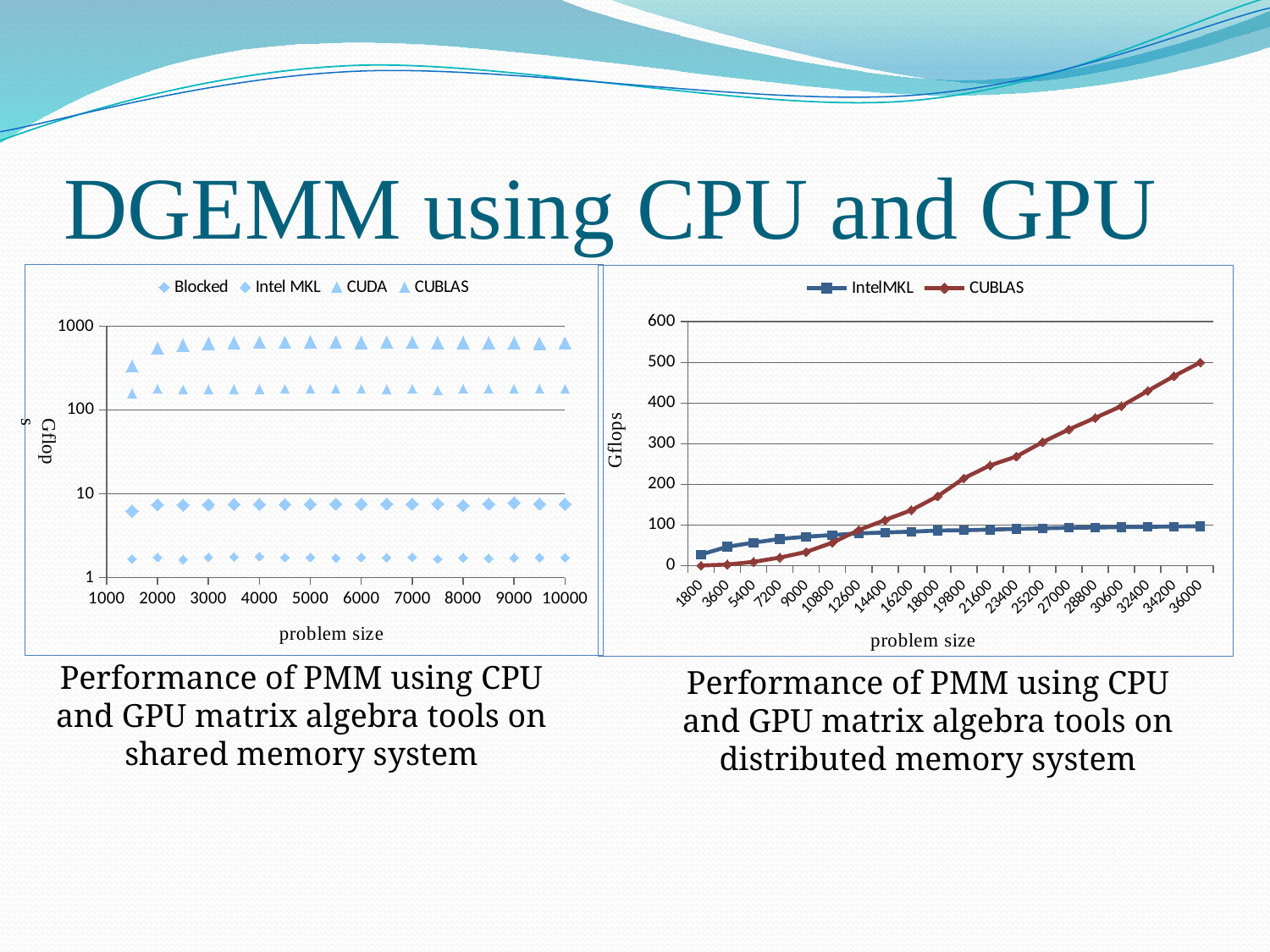
In the right chart (distributed memory system), which series has the larger value at problem size 1800, IntelMKL or CUBLAS? IntelMKL In the left chart (shared memory system), is the CUBLAS value at problem size 5000 greater or less than 100? greater In the left chart (shared memory system), is the Blocked value at problem size 5000 greater or less than 10? less In the right chart (distributed memory system), which series has the larger value at problem size 36000, IntelMKL or CUBLAS? CUBLAS What kind of chart is the right chart (distributed memory system)? line chart In the right chart (distributed memory system), do the CUBLAS values rise or fall as problem size increases? rise In the right chart (distributed memory system), how many problem-size points are shown on the x axis? 20 In the left chart (shared memory system), how many series does the legend list? 4 In the right chart (distributed memory system), is the CUBLAS value at problem size 27000 greater or less than 300? greater In the right chart (distributed memory system), how many series does the legend list? 2 What is the x-axis label of the right chart (distributed memory system)? problem size